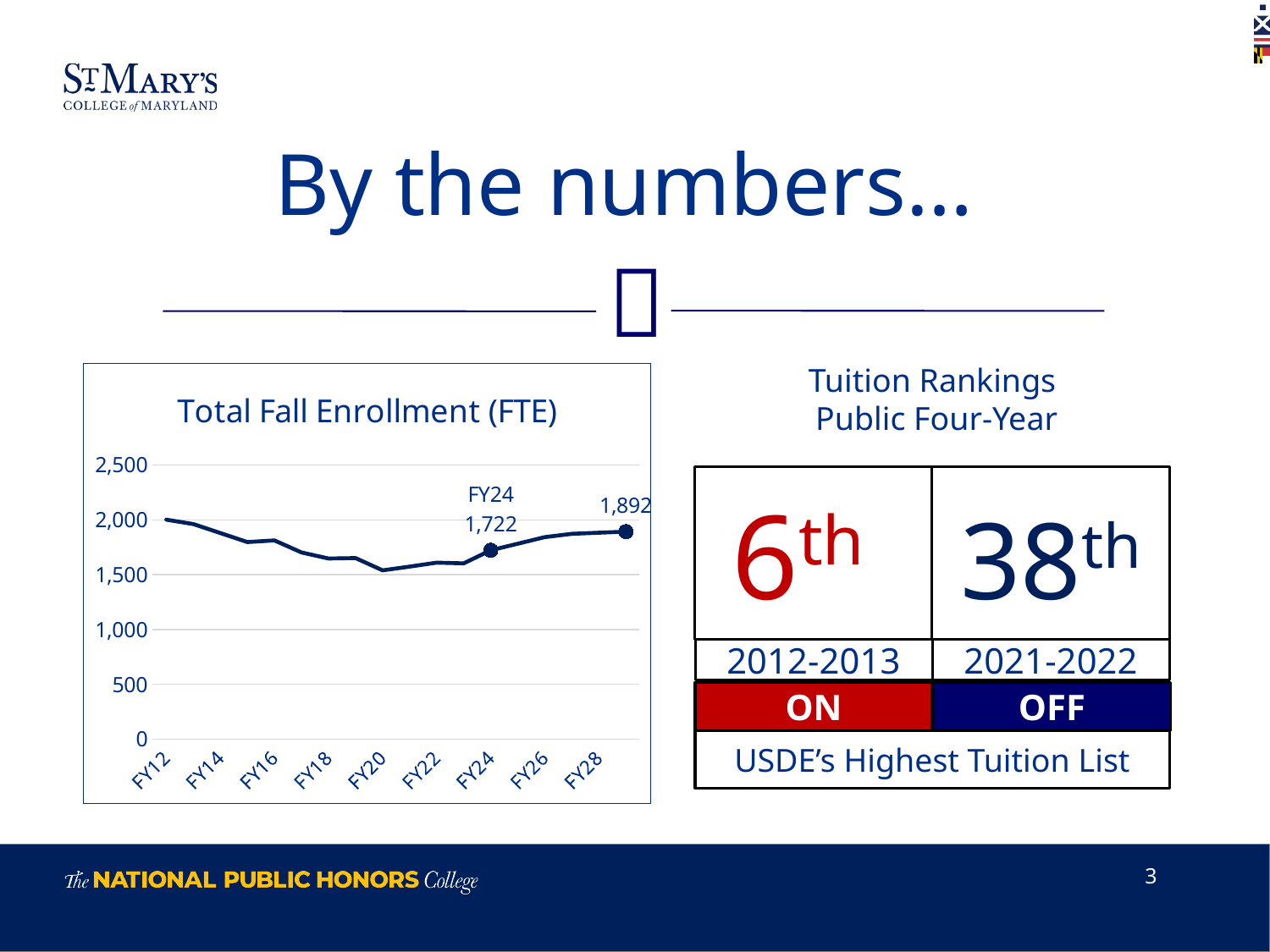
In the Total Fall Enrollment chart, do values rise or fall from FY20 to FY28? rise How many fiscal year labels are shown on the x axis of the Total Fall Enrollment chart? 9 What is the Total Fall Enrollment (FTE) value labelled for FY24? 1,722 In the Total Fall Enrollment chart, is the value for FY12 greater or less than 1,500? greater In the Total Fall Enrollment chart, which is larger, the FY24 value or the FY28 value? FY28 What is the highest value shown on the y axis of the Total Fall Enrollment chart? 2,500 In the Total Fall Enrollment chart, do values rise or fall from FY12 to FY20? fall What kind of chart is the Total Fall Enrollment (FTE) chart? line chart In the Total Fall Enrollment chart, is the value for FY20 greater or less than 2,000? less In the Total Fall Enrollment chart, which fiscal year has the lowest enrollment? FY20